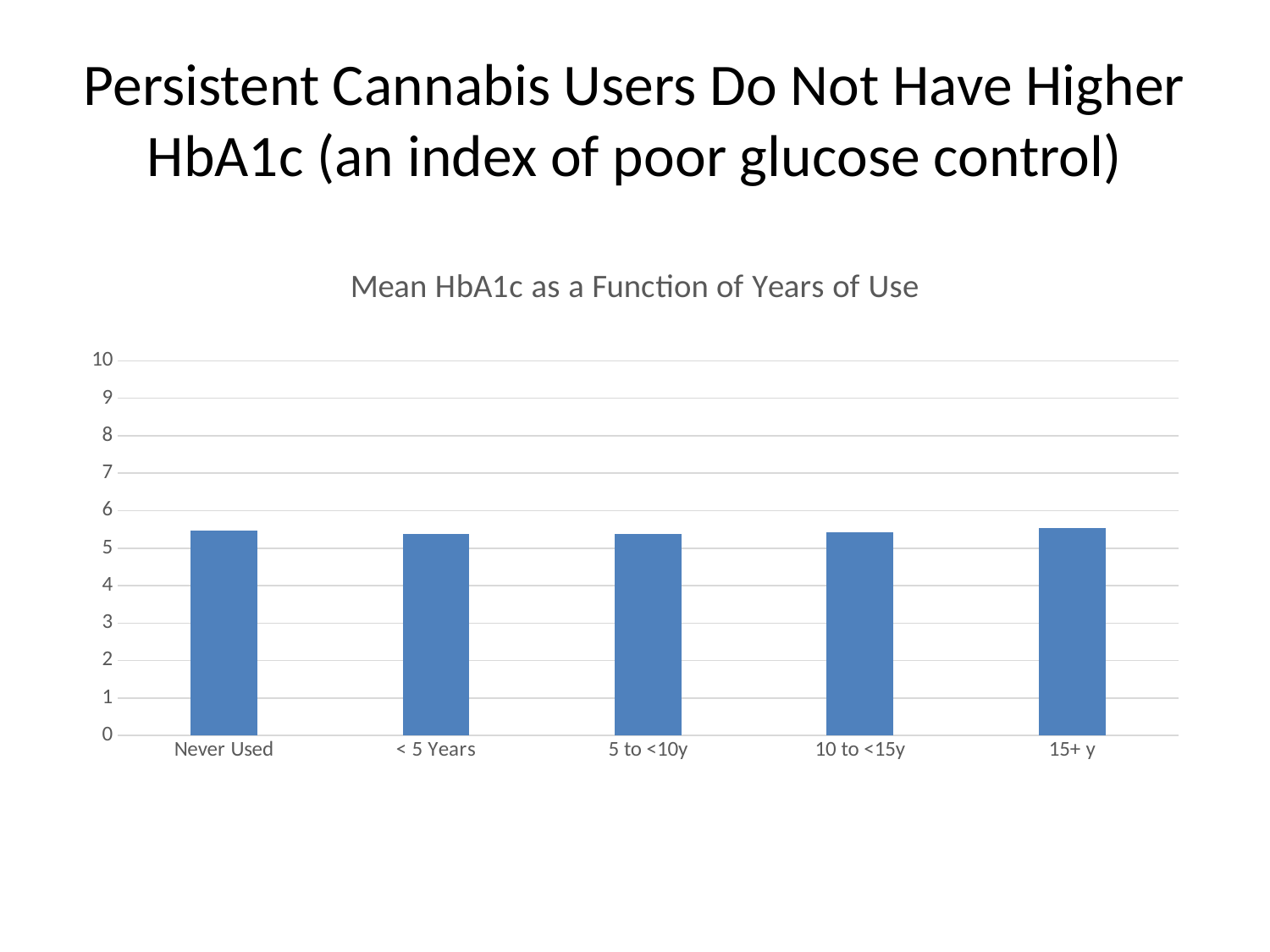
Is the value for Never Used greater or less than 5? greater Is the value for 15+ y greater or less than 5? greater Is the value for 5 to <10y greater or less than 5? greater Do the bar values rise, fall, or stay roughly flat across the years-of-use categories? roughly flat What is the title of the chart? Mean HbA1c as a Function of Years of Use What kind of chart is shown on the slide? bar chart What is the highest value shown on the y axis of the chart? 10 How many categories are shown on the x axis of the chart? 5